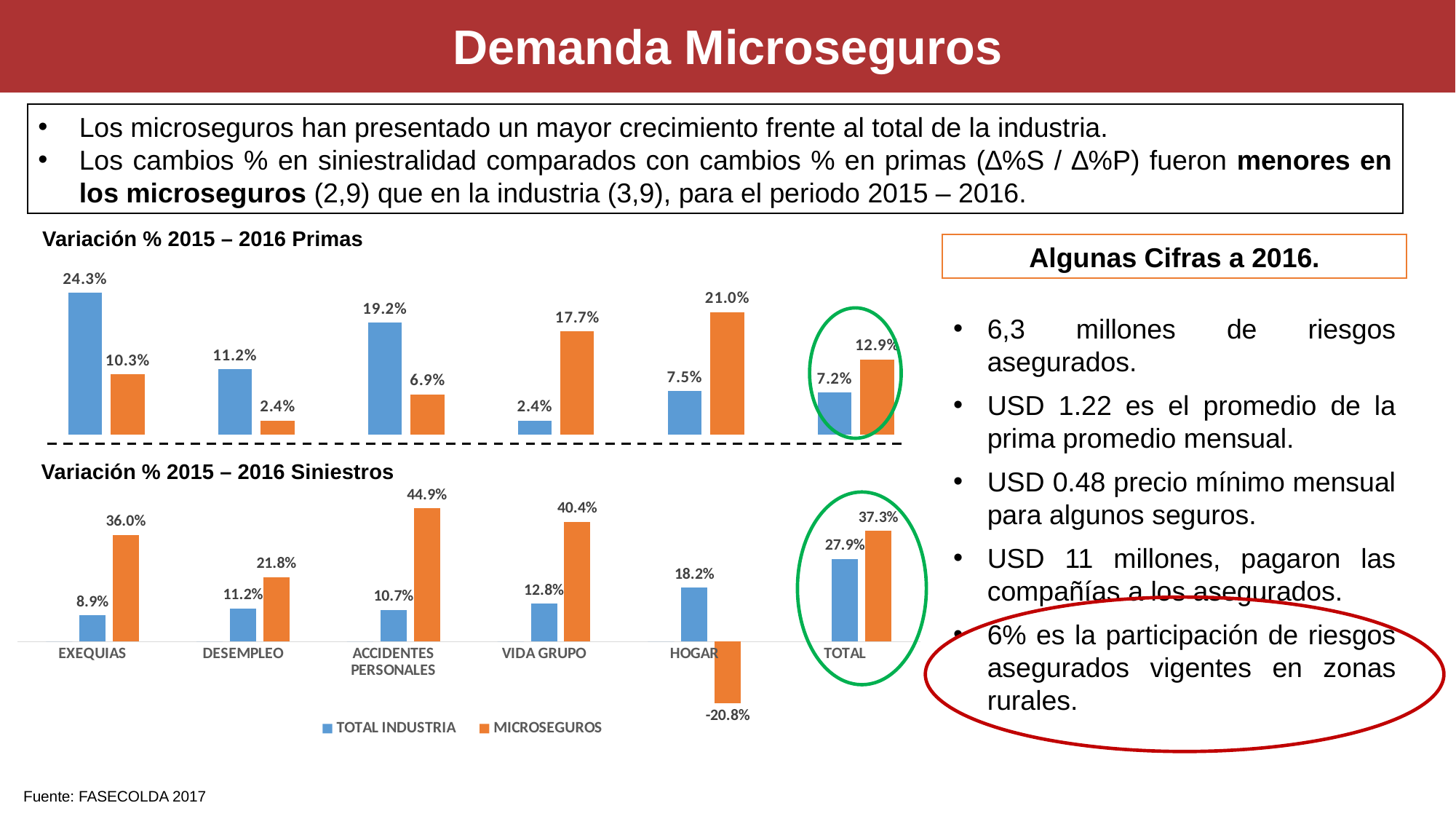
Which colour represents the MICROSEGUROS series in the charts? Orange In the 'Variación % 2015 – 2016 Primas' chart, what is the value for TOTAL INDUSTRIA in the EXEQUIAS category? 24.3% In the 'Variación % 2015 – 2016 Siniestros' chart, what is the MICROSEGUROS value for ACCIDENTES PERSONALES? 44.9% What type of chart is 'Variación % 2015 – 2016 Primas'? Bar chart In the 'Variación % 2015 – 2016 Siniestros' chart, which category has the lowest MICROSEGUROS value? HOGAR How many series does the legend list for the charts on the slide? 2 In the 'Variación % 2015 – 2016 Primas' chart, what is the MICROSEGUROS value for HOGAR? 21.0% In the 'Variación % 2015 – 2016 Siniestros' chart, which is larger for VIDA GRUPO: TOTAL INDUSTRIA or MICROSEGUROS? MICROSEGUROS In the 'Variación % 2015 – 2016 Siniestros' chart, what is the TOTAL INDUSTRIA value for the TOTAL category? 27.9% In the 'Variación % 2015 – 2016 Primas' chart, what is the difference between the MICROSEGUROS and TOTAL INDUSTRIA values for the TOTAL category? 5.7% In the 'Variación % 2015 – 2016 Primas' chart, which category has the highest TOTAL INDUSTRIA value? EXEQUIAS How many categories are shown on the x axis of the 'Variación % 2015 – 2016 Siniestros' chart? 6